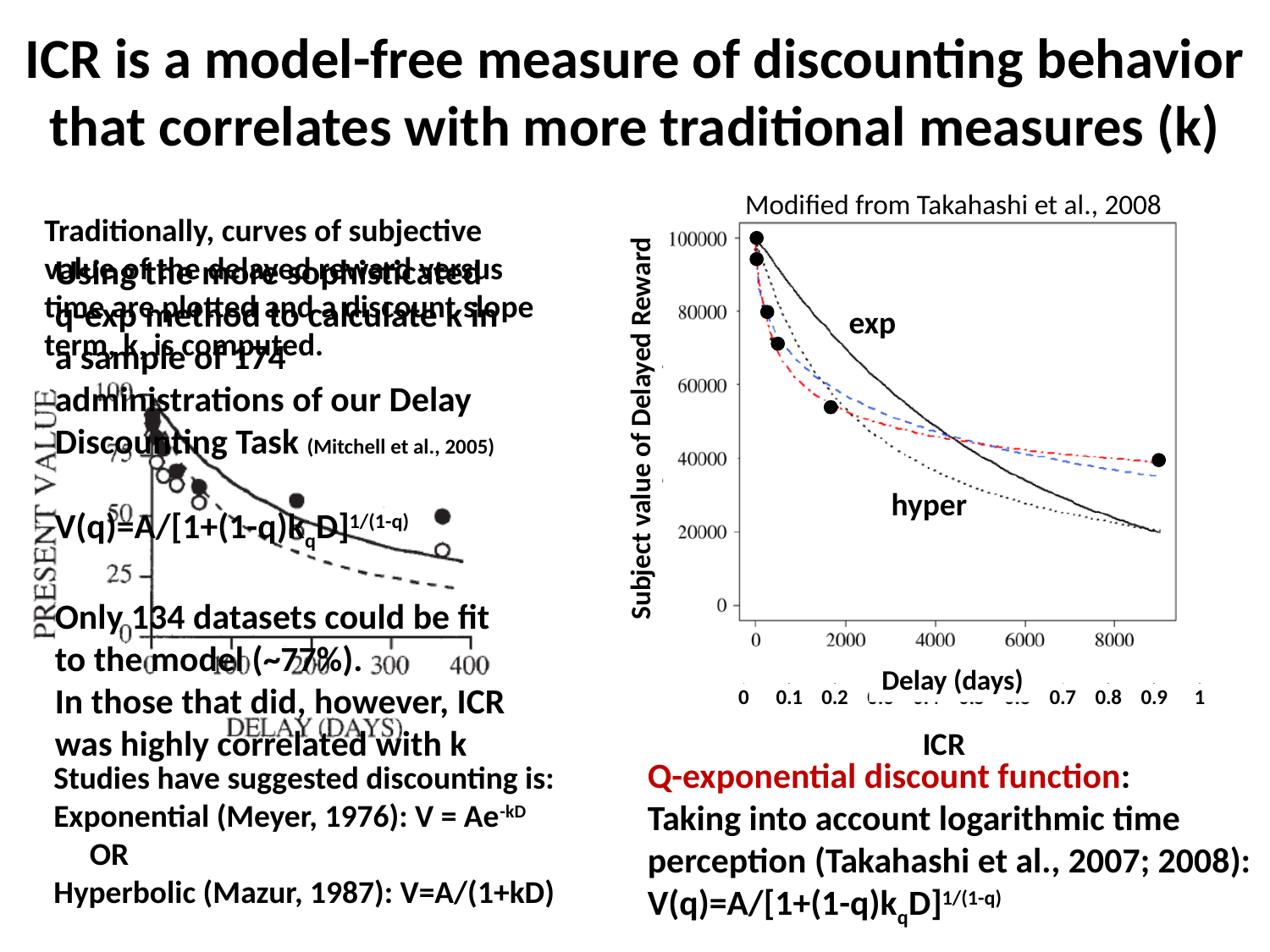
What is the highest tick value shown on the x axis of the right-hand chart? 8000 What is the y-axis label of the right-hand chart? Subject value of Delayed Reward In the right-hand chart, is the value of the data point at the longest delay (around 9000 days) greater or less than 60000? less What is the highest tick value shown on the x axis of the left-hand chart (DELAY (DAYS))? 400 In the left-hand chart (PRESENT VALUE vs DELAY (DAYS)), do the plotted values rise or fall as delay increases? fall What is the highest tick value shown on the y axis of the right-hand chart? 100000 What kind of chart is the right-hand chart (Subject value of Delayed Reward vs Delay)? line chart In the right-hand chart, do the plotted values rise or fall as delay increases along the x axis? fall In the right-hand chart, is the value of the first data point at delay 0 greater or less than 80000? greater In the right-hand chart, is the value of the data point near a delay of 2000 days greater or less than 60000? less What source is the right-hand chart attributed to? Modified from Takahashi et al., 2008